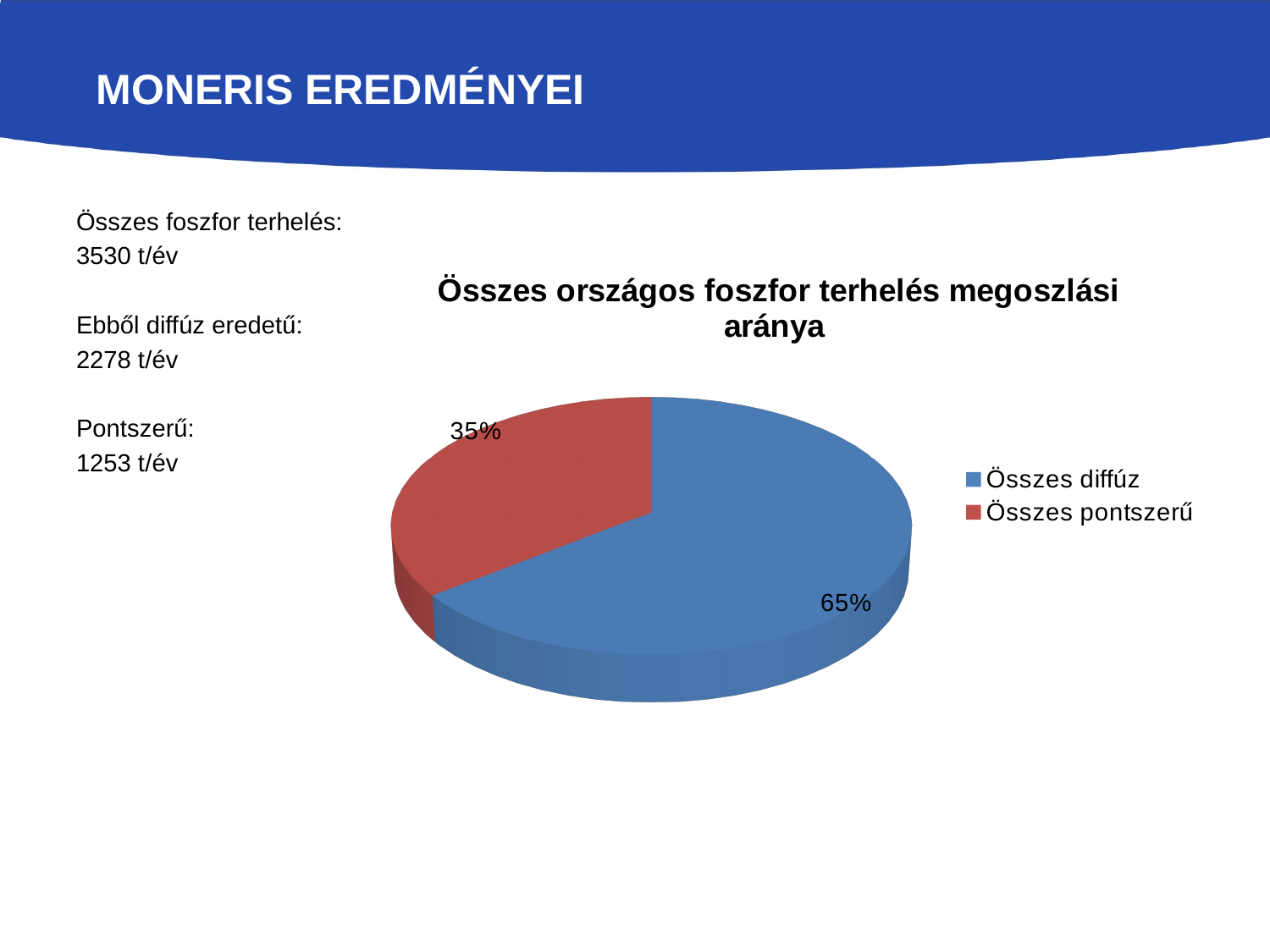
What is the title of the chart? Összes országos foszfor terhelés megoszlási aránya How many slices does the pie chart have? 2 Which slice of the pie is the largest? Összes diffúz What is the difference in percentage points between the Összes diffúz and Összes pontszerű slices? 30 percentage points What share of the pie does Összes diffúz represent? 65% What kind of chart is shown on the slide? pie chart What colour is the Összes pontszerű slice? red What share of the pie does Összes pontszerű represent? 35% Which slice of the pie is the smallest? Összes pontszerű Which is larger, the share for Összes diffúz or the share for Összes pontszerű? Összes diffúz How many entries does the legend list? 2